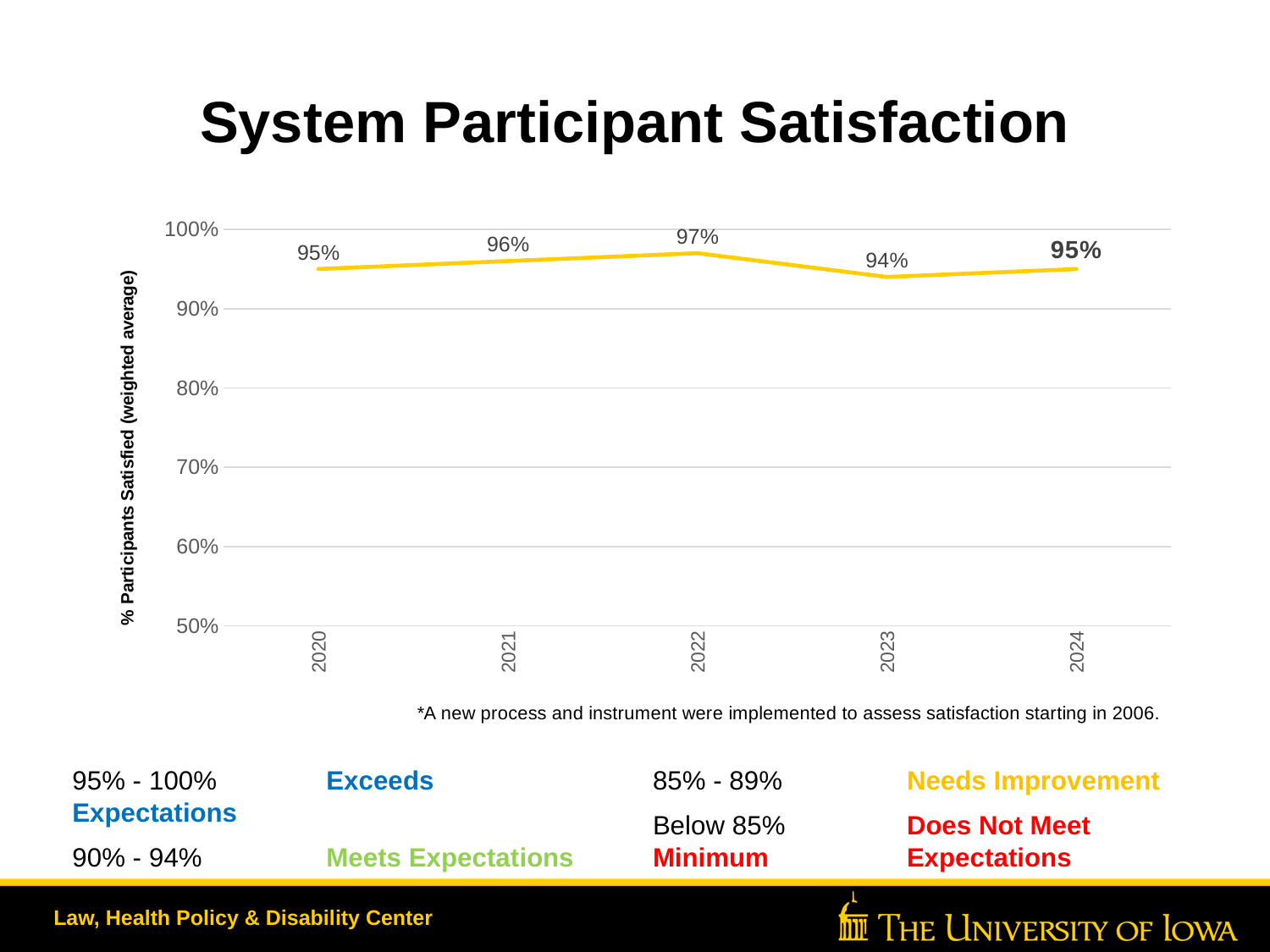
What is the % Participants Satisfied value for 2023? 94% Which year has the lowest % Participants Satisfied? 2023 What is the title of the chart? System Participant Satisfaction Which is larger, the value for 2021 or the value for 2023? 2021 What is the difference between the 2022 value and the 2023 value? 3% Is the value for 2023 greater or less than 90%? greater What is the % Participants Satisfied value for 2020? 95% Which year has the highest % Participants Satisfied? 2022 What is the % Participants Satisfied value for 2024? 95% What kind of chart is shown on the slide? line chart How many years are plotted on the x axis? 5 What is the % Participants Satisfied value for 2022? 97%